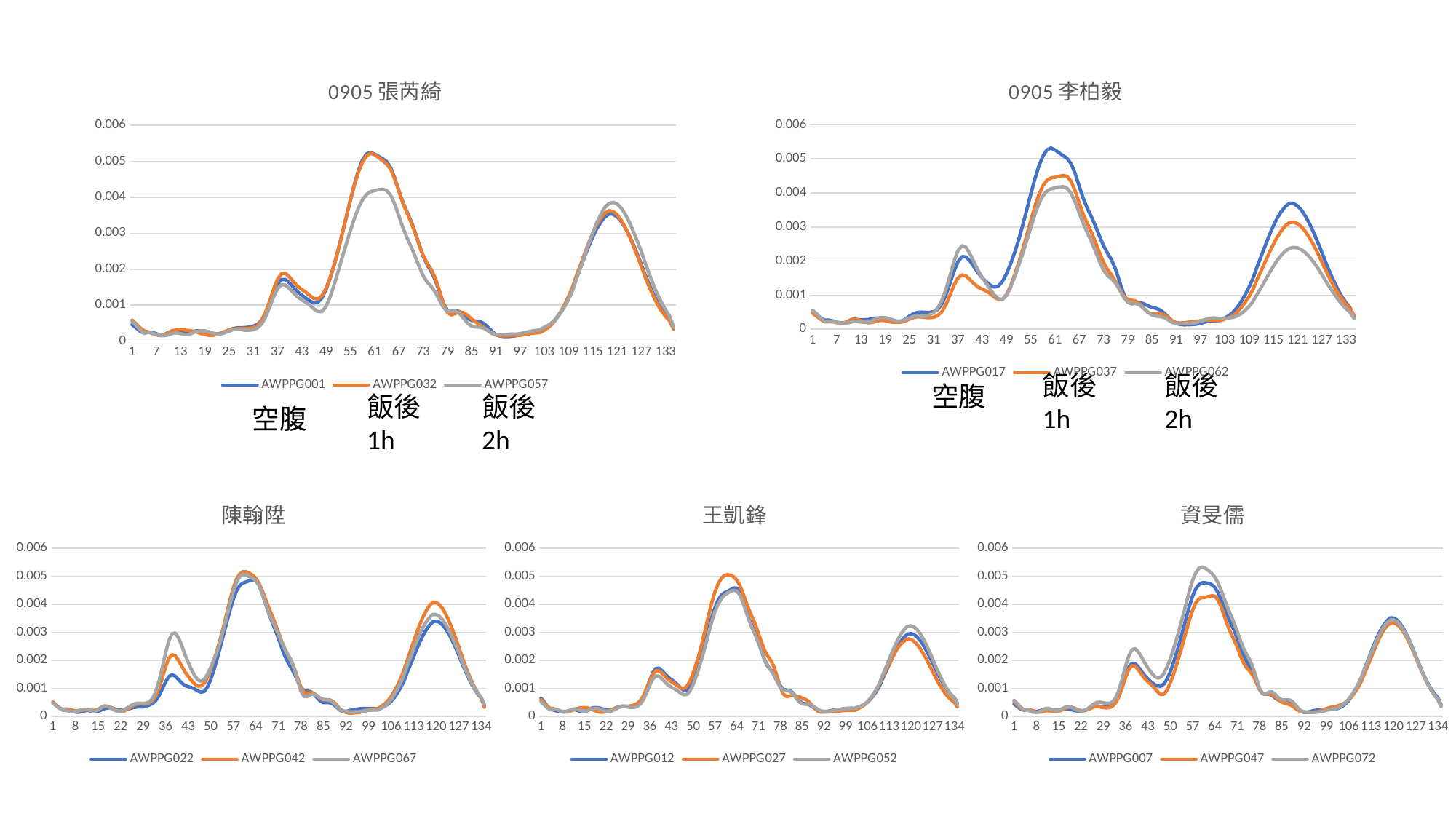
What is the highest value shown on the y axis of the '陳翰陞' chart? 0.006 In the '資旻儒' chart, is the peak of AWPPG072 near x=57 greater or less than 0.005? greater In the '0905 李柏毅' chart, is the peak of AWPPG017 near x=61 greater or less than 0.005? greater In the '王凱鋒' chart, is the peak of AWPPG027 near x=61 greater or less than 0.004? greater What are the legend entries of the '陳翰陞' chart? AWPPG022, AWPPG042, AWPPG067 In the '陳翰陞' chart, at the peak near x=120, which series is higher, AWPPG042 or AWPPG022? AWPPG042 In the '0905 張芮綺' chart, which series has the lowest peak around x=61? AWPPG057 What kind of chart is the '0905 張芮綺' chart? Line chart How many series does the legend of the '0905 李柏毅' chart list? 3 In the '0905 李柏毅' chart, at the peak near x=120, which series is higher, AWPPG017 or AWPPG062? AWPPG017 How many charts are shown on the slide? 5